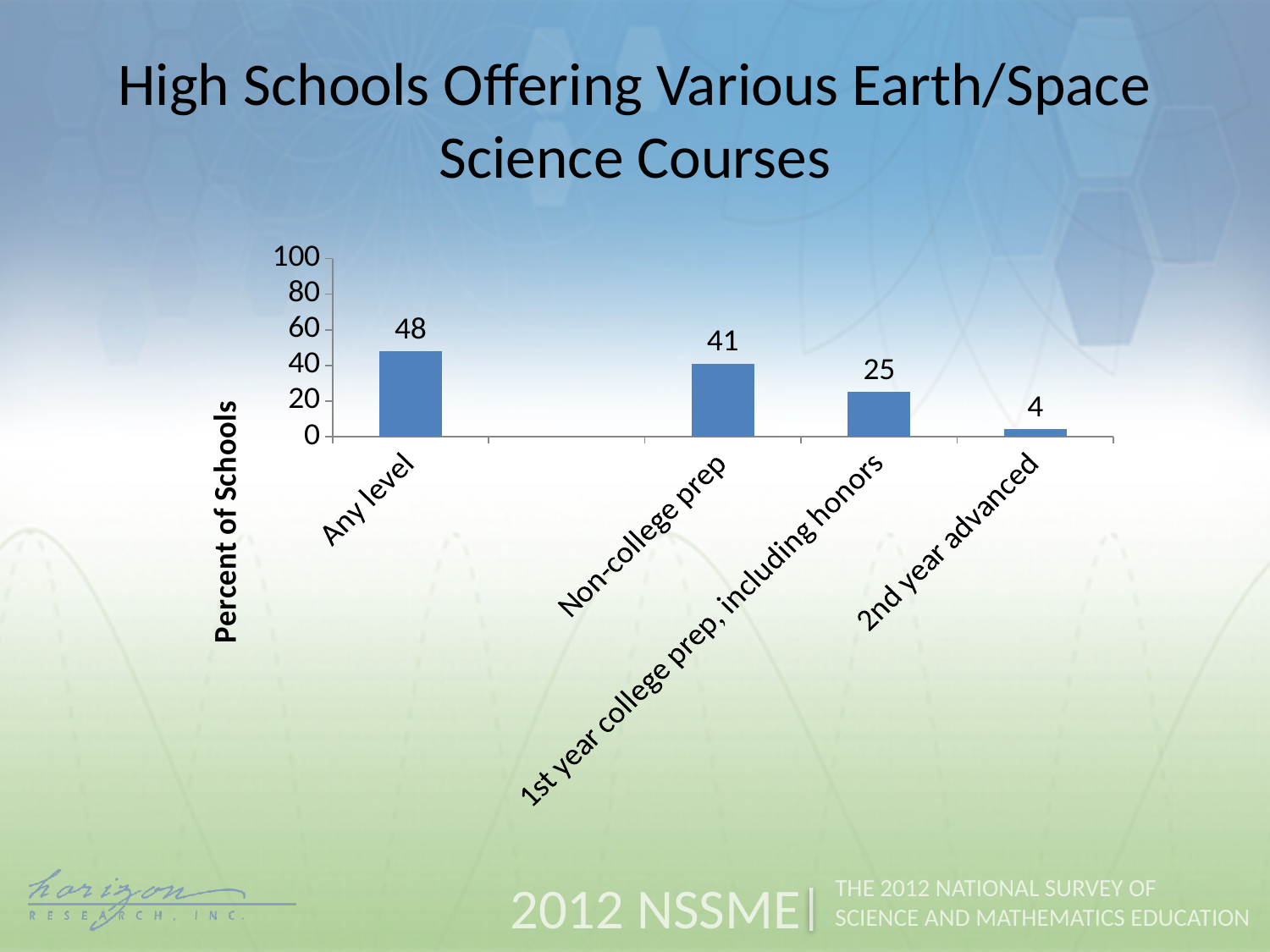
What is the difference between the values for Any level and Non-college prep? 7 What is the difference between the values for Non-college prep and 2nd year advanced? 37 Which category has the lowest value? 2nd year advanced Which is larger, the value for Non-college prep or the value for 1st year college prep, including honors? Non-college prep What kind of chart is shown on the slide? Bar chart What is the label of the vertical axis? Percent of Schools What is the value for Non-college prep? 41 How many categories are shown on the x axis? 4 Which category has the highest value? Any level What is the value for 2nd year advanced? 4 What is the value for 1st year college prep, including honors? 25 What percent of high schools offer earth/space science at any level? 48